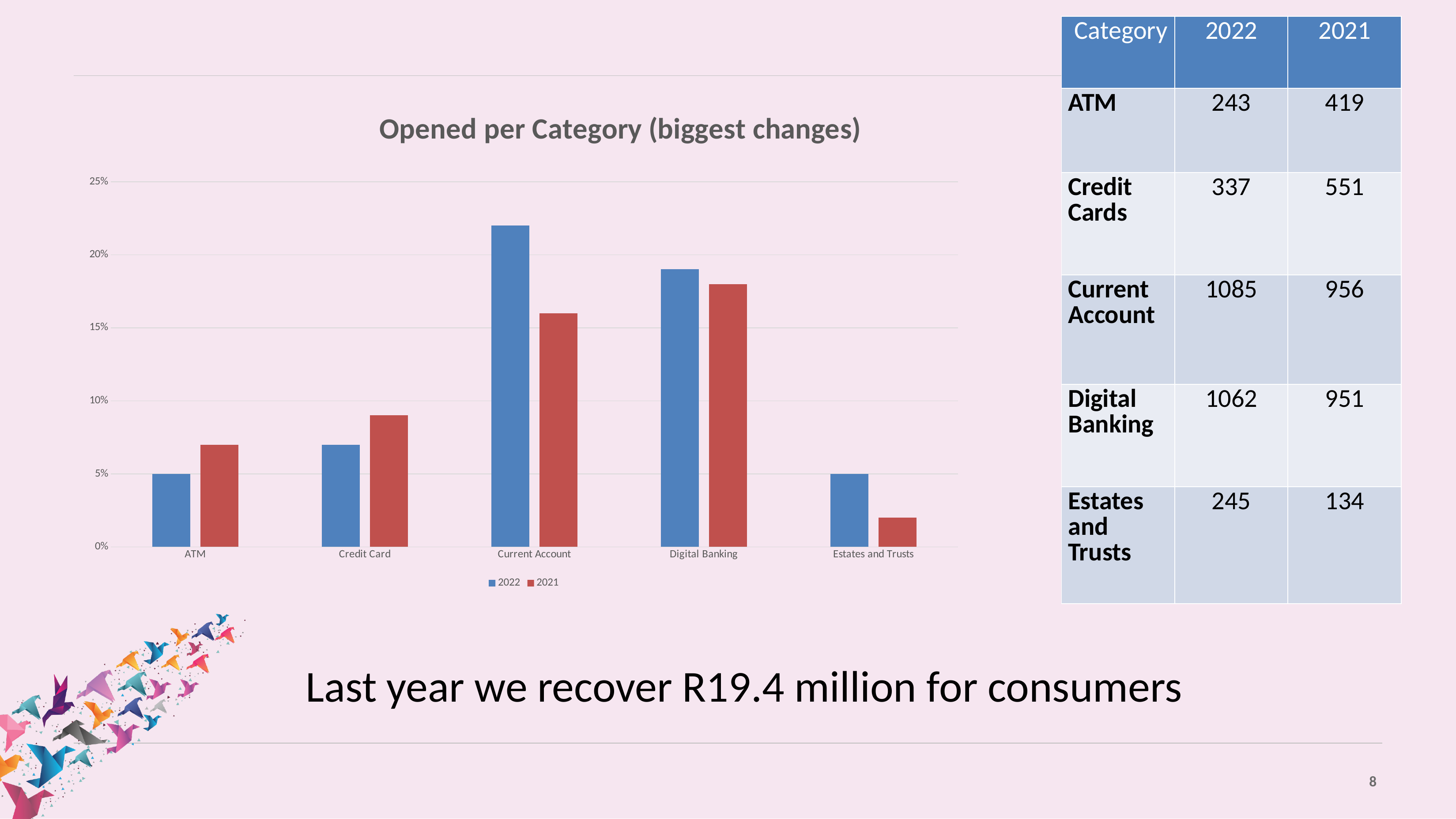
Which category has the highest 2022 value in the chart? Current Account Is the 2022 value for Current Account greater or less than 20%? greater How many series does the chart legend list? 2 How many categories are shown on the x axis of the chart? 5 Which category has the lowest 2021 value in the chart? Estates and Trusts What is the title of the chart? Opened per Category (biggest changes) Is the 2021 value for Estates and Trusts greater or less than 5%? less Which category has the highest 2021 value in the chart? Digital Banking Is the 2021 value for Credit Card greater or less than 10%? less For ATM, which series has the larger value, 2022 or 2021? 2021 For Current Account, which series has the larger value, 2022 or 2021? 2022 What kind of chart is shown on the slide? Bar chart